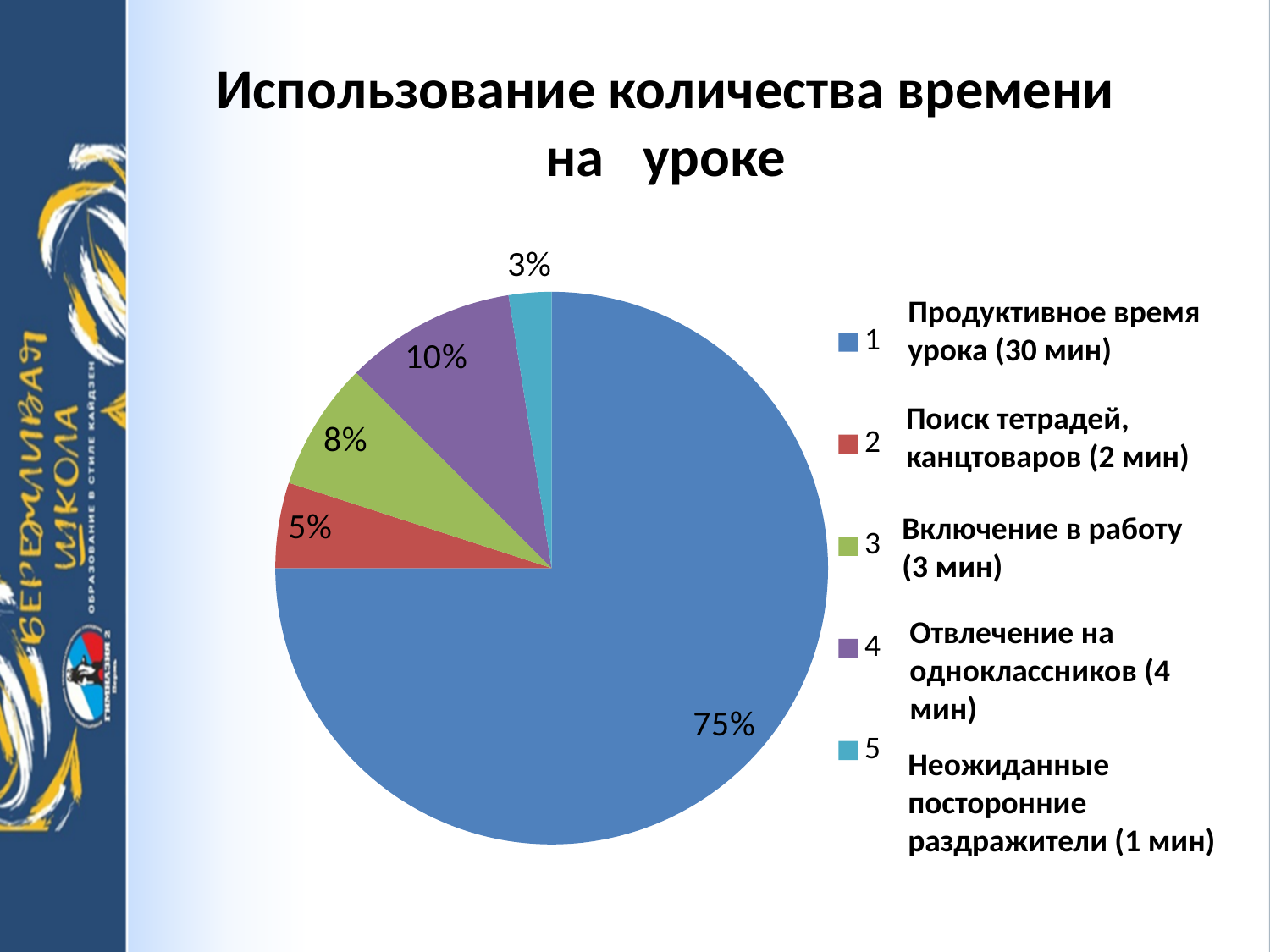
What is the difference between the slice for Отвлечение на одноклассников and the slice for Включение в работу? 2% What share of the pie does the slice for legend entry 1 (Продуктивное время урока) take? 75% What percentage is shown for the slice for legend entry 2 (Поиск тетрадей, канцтоваров)? 5% What kind of chart is shown on the slide? pie chart Which slice of the pie chart is the largest? Продуктивное время урока (75%) Which is larger: the slice for Поиск тетрадей, канцтоваров or the slice for Включение в работу? Включение в работу What percentage is shown for the slice for legend entry 3 (Включение в работу)? 8% How many slices does the pie chart have? 5 What percentage is shown for the slice for legend entry 4 (Отвлечение на одноклассников)? 10% Which slice of the pie chart is the smallest? Неожиданные посторонние раздражители (3%) What is the title of the chart on the slide? Использование количества времени на уроке What percentage is shown for the slice for legend entry 5 (Неожиданные посторонние раздражители)? 3%